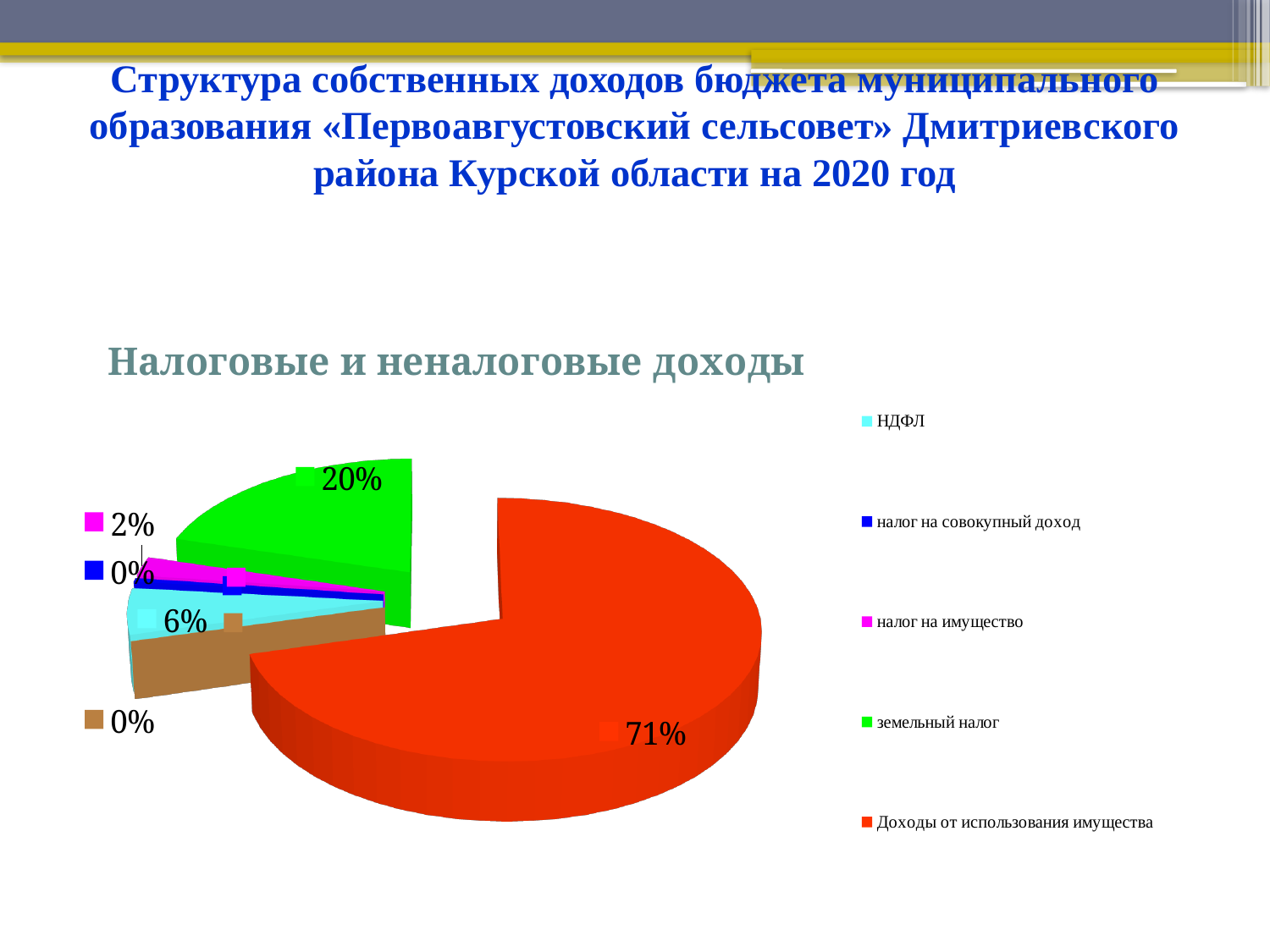
What is the title of the pie chart? Налоговые и неналоговые доходы By how many percentage points does Доходы от использования имущества exceed земельный налог? 51 percentage points What percentage is shown for земельный налог? 20% By how many percentage points does земельный налог exceed НДФЛ? 14 percentage points How many entries does the legend list? 5 What percentage is shown for налог на имущество? 2% What share of the pie is labelled for Доходы от использования имущества? 71% What percentage is shown for налог на совокупный доход? 0% What kind of chart is shown on the slide? Pie chart Which category has the largest slice of the pie? Доходы от использования имущества Which is larger: the slice for земельный налог or the slice for НДФЛ? земельный налог What percentage is shown for НДФЛ? 6%